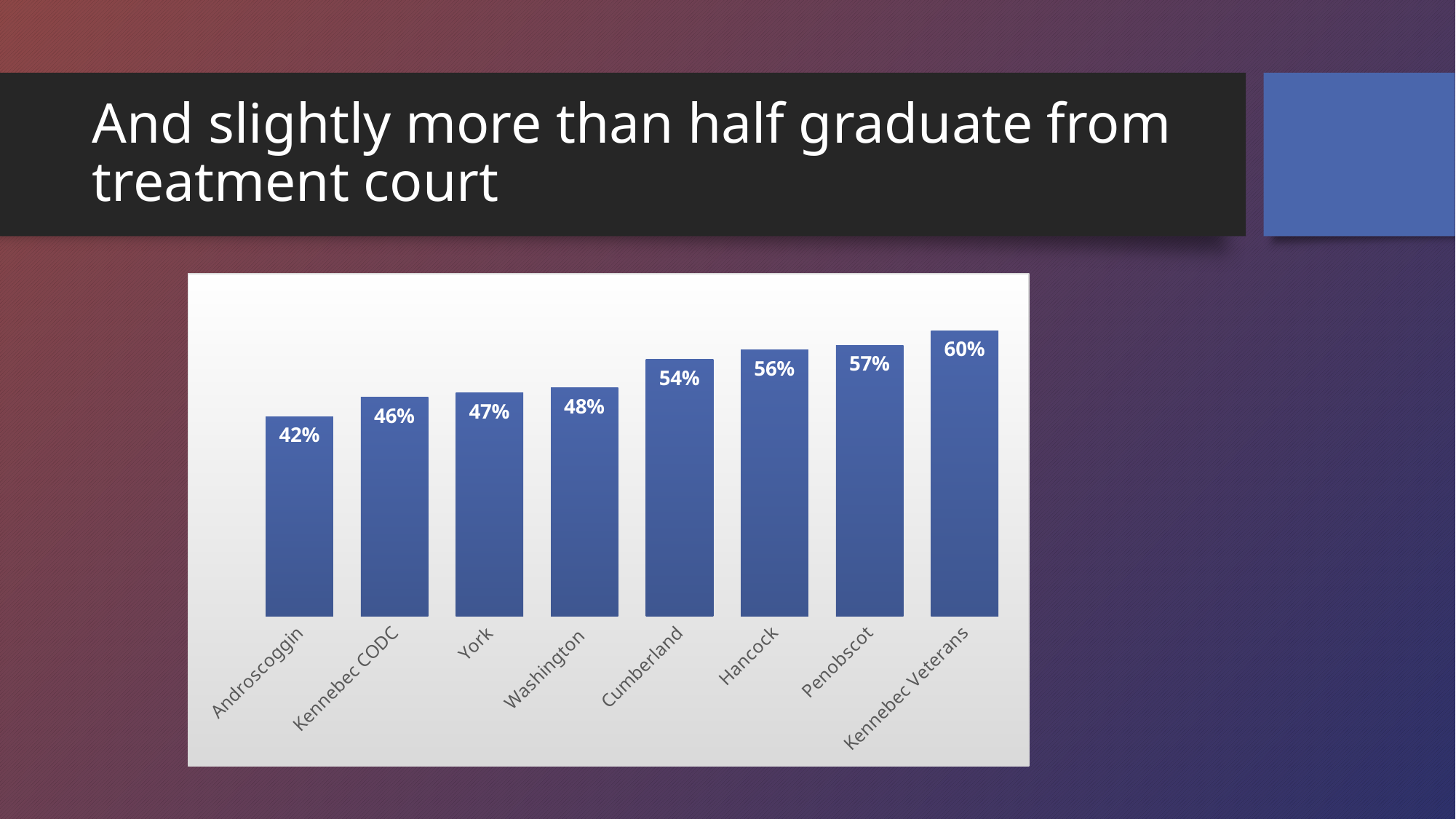
What is the value for Androscoggin? 42% What kind of chart is shown on the slide? Bar chart Which is larger, the value for Washington or the value for Hancock? Hancock What is the difference between the values for Penobscot and York? 10% What is the difference between the values for Kennebec Veterans and Androscoggin? 18% How many categories are shown in the chart? 8 What is the value for Hancock? 56% Do the values rise or fall from left to right along the x axis? Rise What is the value for Cumberland? 54% What is the value for Kennebec Veterans? 60% Which category has the highest value? Kennebec Veterans Which category has the lowest value? Androscoggin